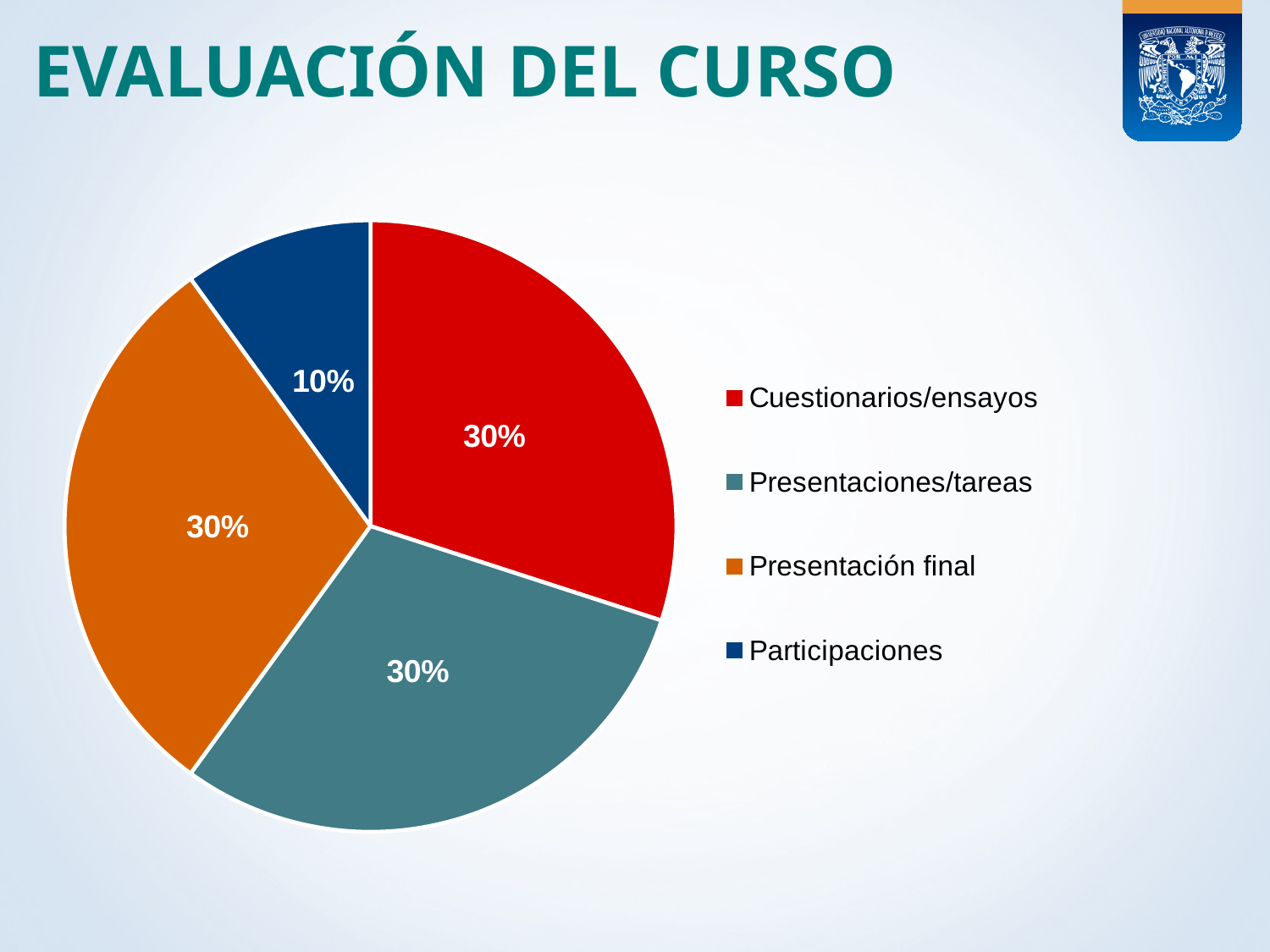
What share of the pie does Presentación final represent? 30% What kind of chart is shown on the slide? Pie chart What is the difference between the value for Presentación final and the value for Participaciones? 20% What is the value shown for Presentaciones/tareas? 30% What share of the pie does Participaciones represent? 10% How many entries does the legend list? 4 What share of the pie does Cuestionarios/ensayos represent? 30% Which is larger, the value for Cuestionarios/ensayos or the value for Participaciones? Cuestionarios/ensayos Which category has the smallest slice of the pie? Participaciones How many slices does the pie chart have? 4 What is the title of the slide containing the chart? EVALUACIÓN DEL CURSO What colour is the slice for Participaciones? Dark blue